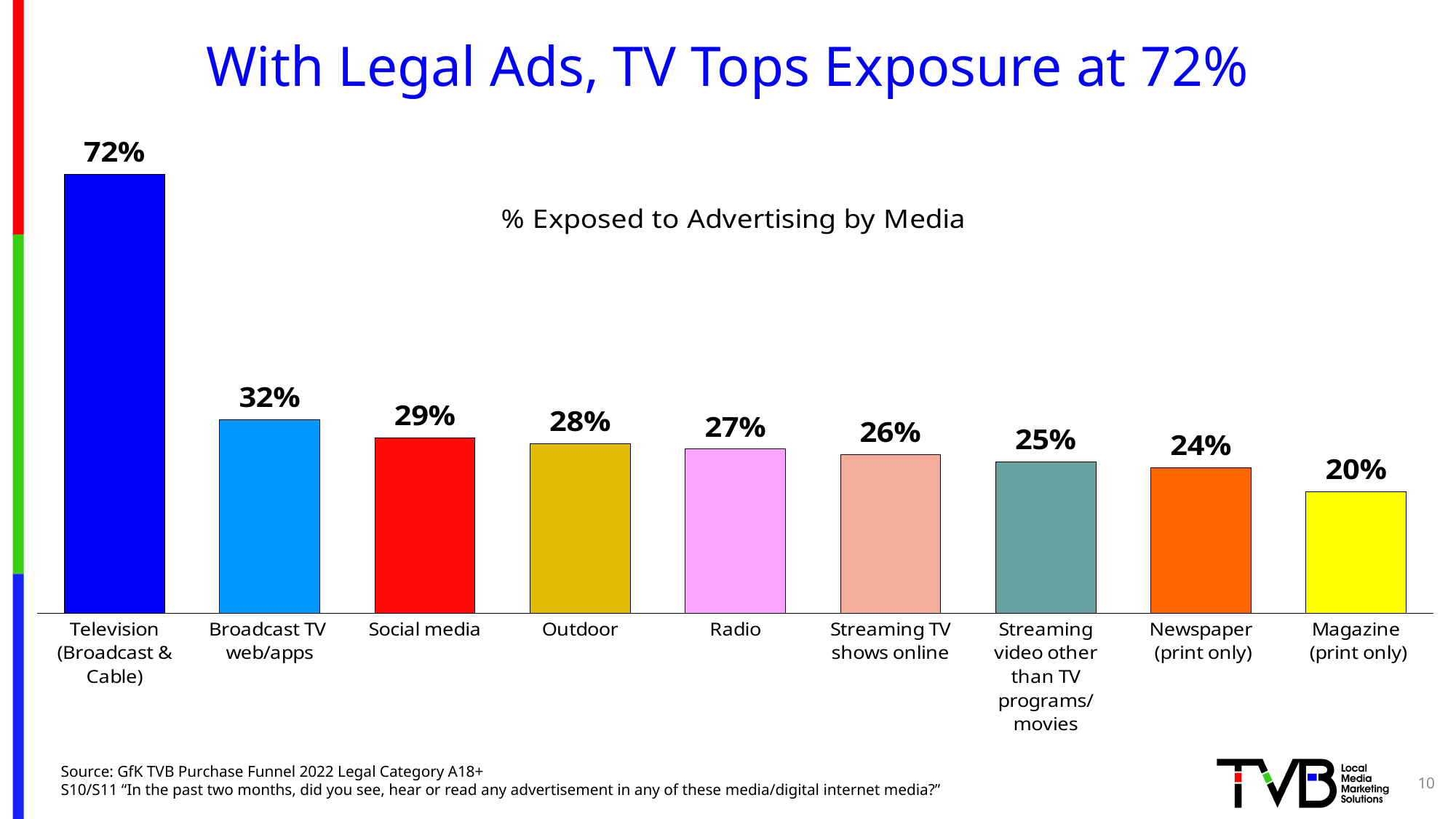
Which category has the lowest value? Magazine (print only) Which category has the highest value? Television (Broadcast & Cable) Which is larger, the value for Outdoor or the value for Streaming video other than TV programs/movies? Outdoor What kind of chart is shown on the slide? Bar chart What is the difference between the values for Social media and Magazine (print only)? 9% What is the value for Television (Broadcast & Cable)? 72% What is the title of the chart? % Exposed to Advertising by Media What is the difference between the values for Television (Broadcast & Cable) and Broadcast TV web/apps? 40% Do the values rise or fall from left to right across the categories? Fall What is the value for Newspaper (print only)? 24% How many categories are shown in the chart? 9 What is the value for Radio? 27%